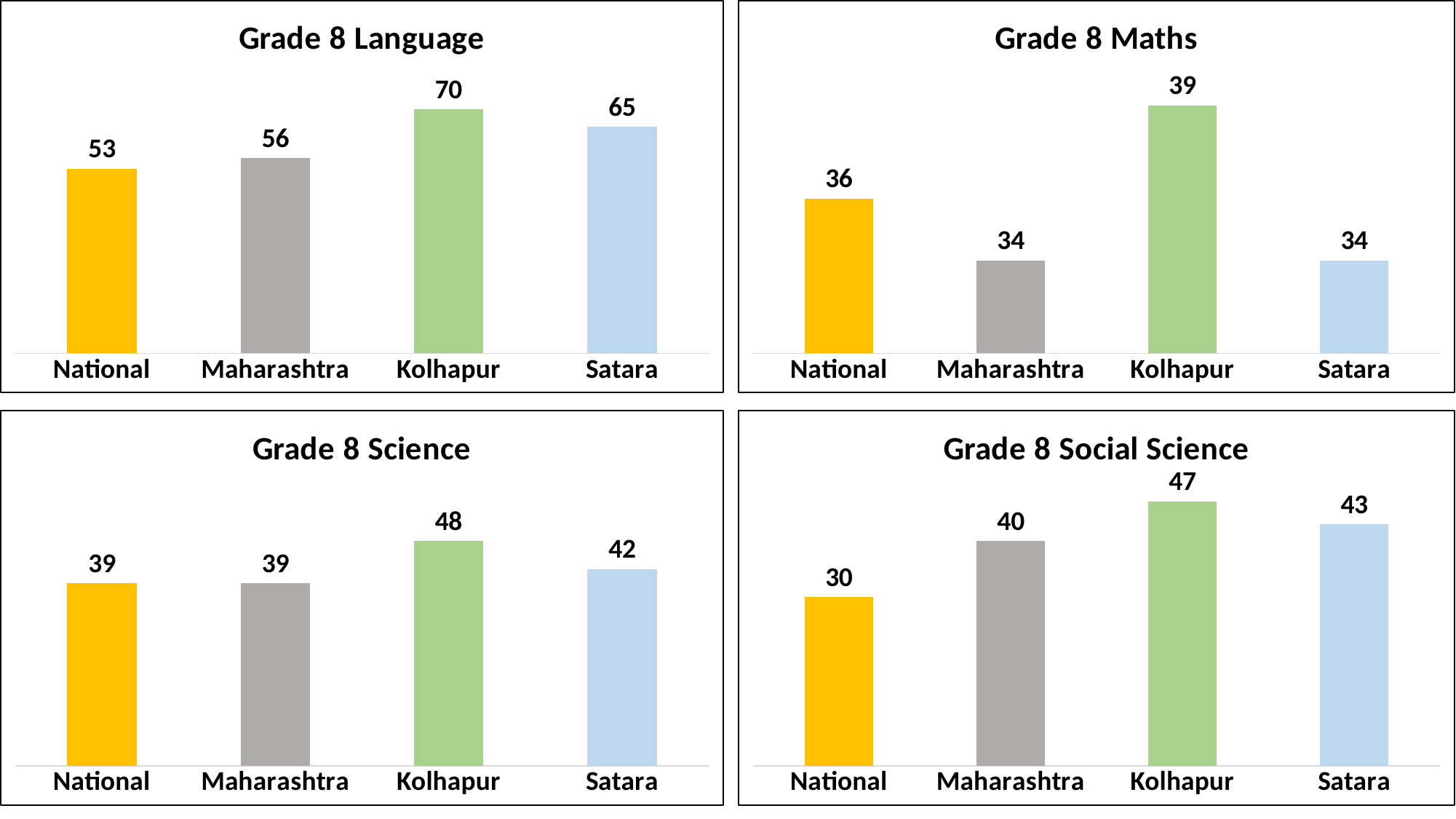
In the Grade 8 Language chart, what is the difference between the values for Kolhapur and National? 17 How many categories are shown in the Grade 8 Maths chart? 4 In the Grade 8 Maths chart, what is the value for National? 36 In the Grade 8 Science chart, which is larger, the value for Satara or the value for Maharashtra? Satara In the Grade 8 Social Science chart, what is the value for Satara? 43 In the Grade 8 Science chart, which category has the highest value? Kolhapur In the Grade 8 Social Science chart, which category has the lowest value? National In the Grade 8 Maths chart, what is the difference between the values for Kolhapur and Maharashtra? 5 How many charts are shown on the slide? 4 In the Grade 8 Language chart, which is larger, the value for Satara or the value for Maharashtra? Satara In the Grade 8 Language chart, what is the value for Kolhapur? 70 What kind of chart is the Grade 8 Social Science chart? Bar chart